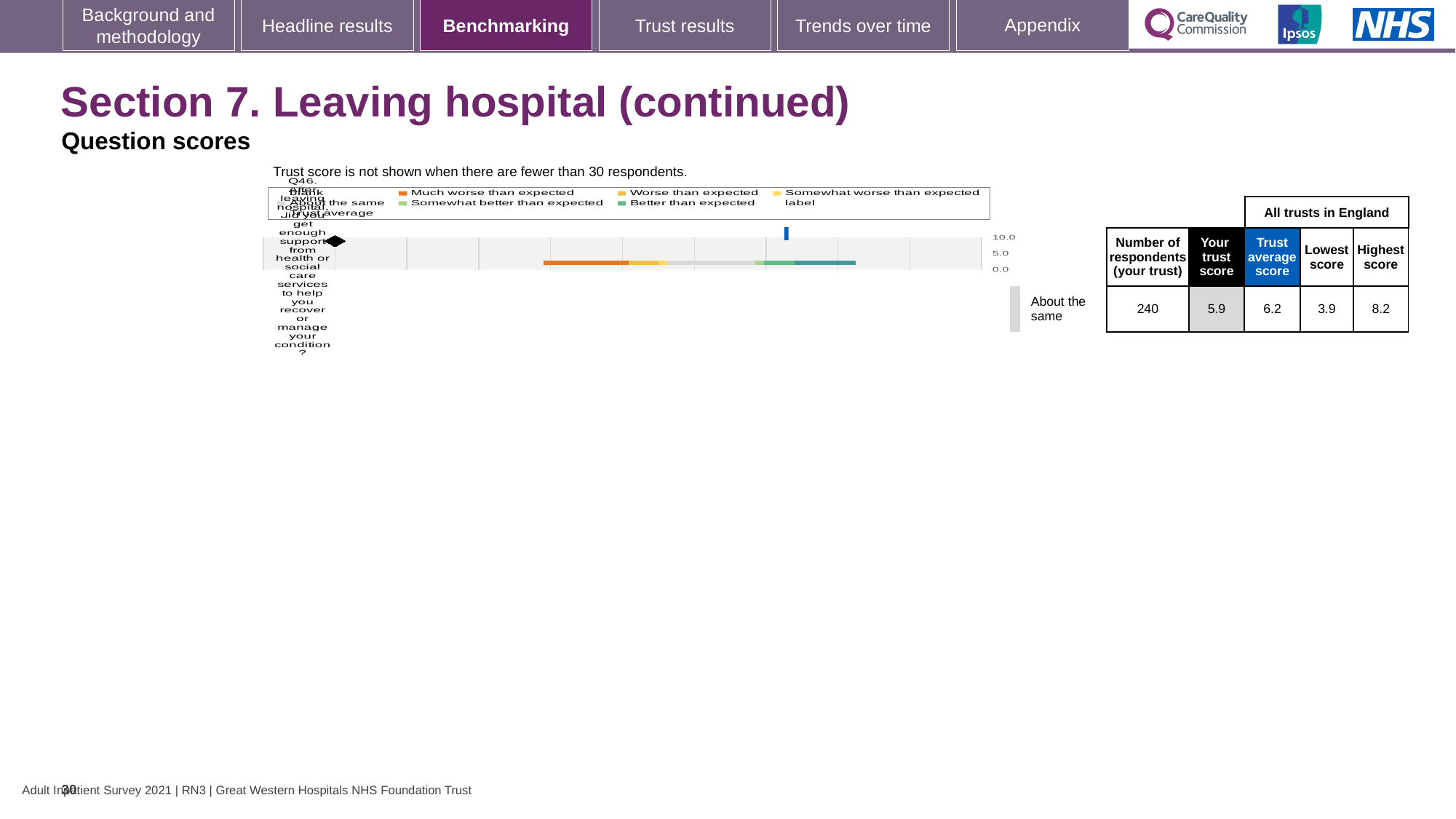
What is the highest value shown on the chart's axis? 10.0 How many respondents from the trust answered Q46? 240 Which benchmark category is the trust's Q46 score placed in, according to the label beside the chart? About the same Which is larger for Q46: the trust's score or the trust average score? Trust average score What is the highest score for Q46 among all trusts in England? 8.2 What is the trust's score for Q46? 5.9 What kind of chart is shown for Q46 on this slide? bar chart Is the trust's score marker for Q46 greater or less than 5.0 on the chart axis? greater What is the difference between the highest and lowest scores for Q46 among all trusts in England? 4.3 What is the lowest score for Q46 among all trusts in England? 3.9 What is the difference between the trust average score and the trust's own score for Q46? 0.3 What is the trust average score for Q46 across all trusts in England? 6.2